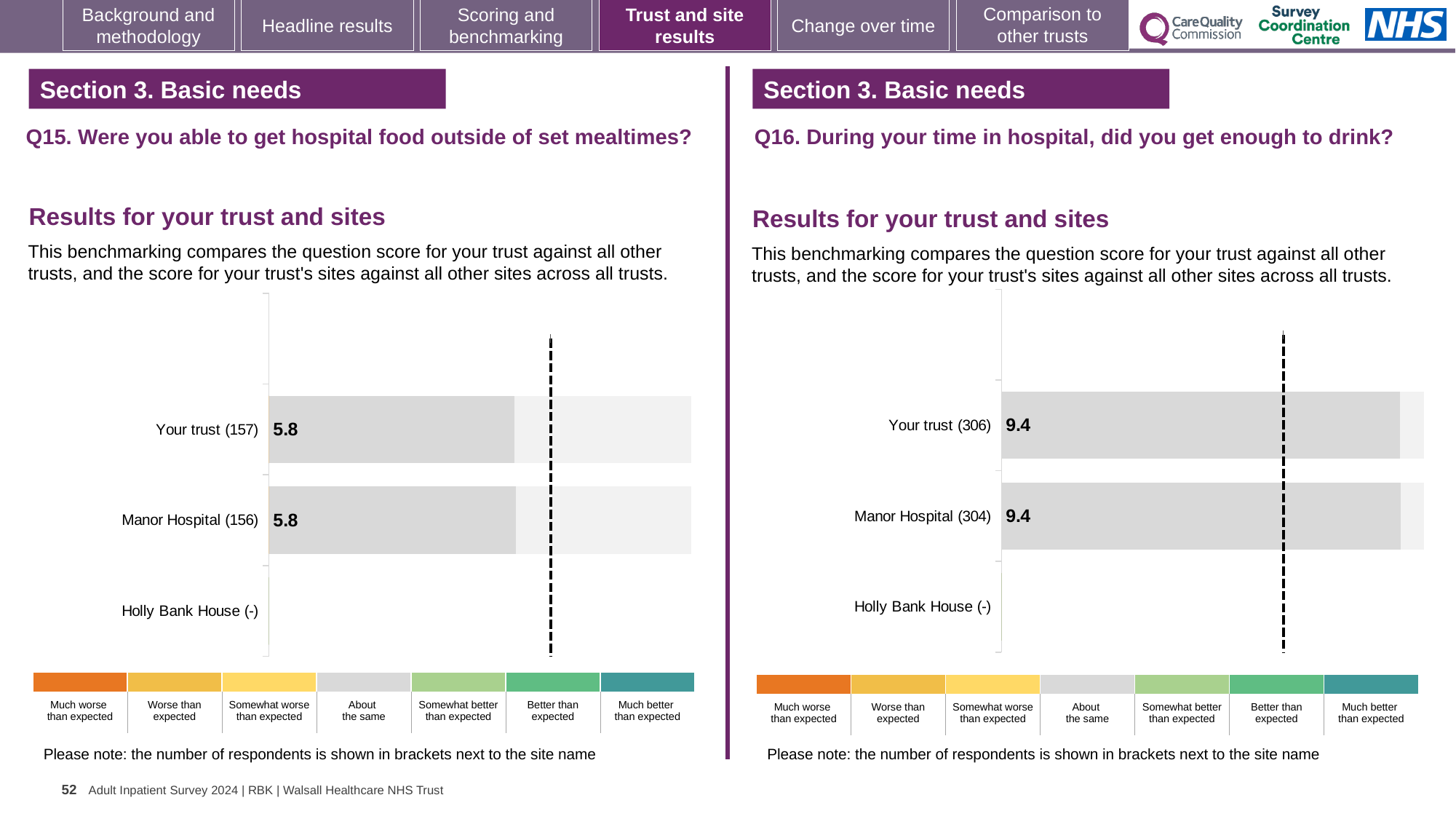
On the Q16 chart (right), how many respondents are shown in brackets for Manor Hospital? 304 What kind of chart is used for the Q16 results (right)? Bar chart On the Q15 chart (left), how many respondents are shown in brackets for Your trust? 157 On the Q16 chart (right), what is the score for Your trust? 9.4 On the Q16 chart (right), how many respondents are shown in brackets for Your trust? 306 On the Q16 chart (right), which site has no score shown? Holly Bank House On the Q15 chart (left), what is the difference between the scores for Your trust and Manor Hospital? 0 On the Q15 chart (left), how many sites or categories are listed on the vertical axis? 3 On the Q16 chart (right), what is the score for Manor Hospital? 9.4 On the Q15 chart (left), what is the score for Manor Hospital? 5.8 On the Q15 chart (left), how many respondents are shown in brackets for Manor Hospital? 156 On the Q15 chart (left), what is the score for Your trust? 5.8